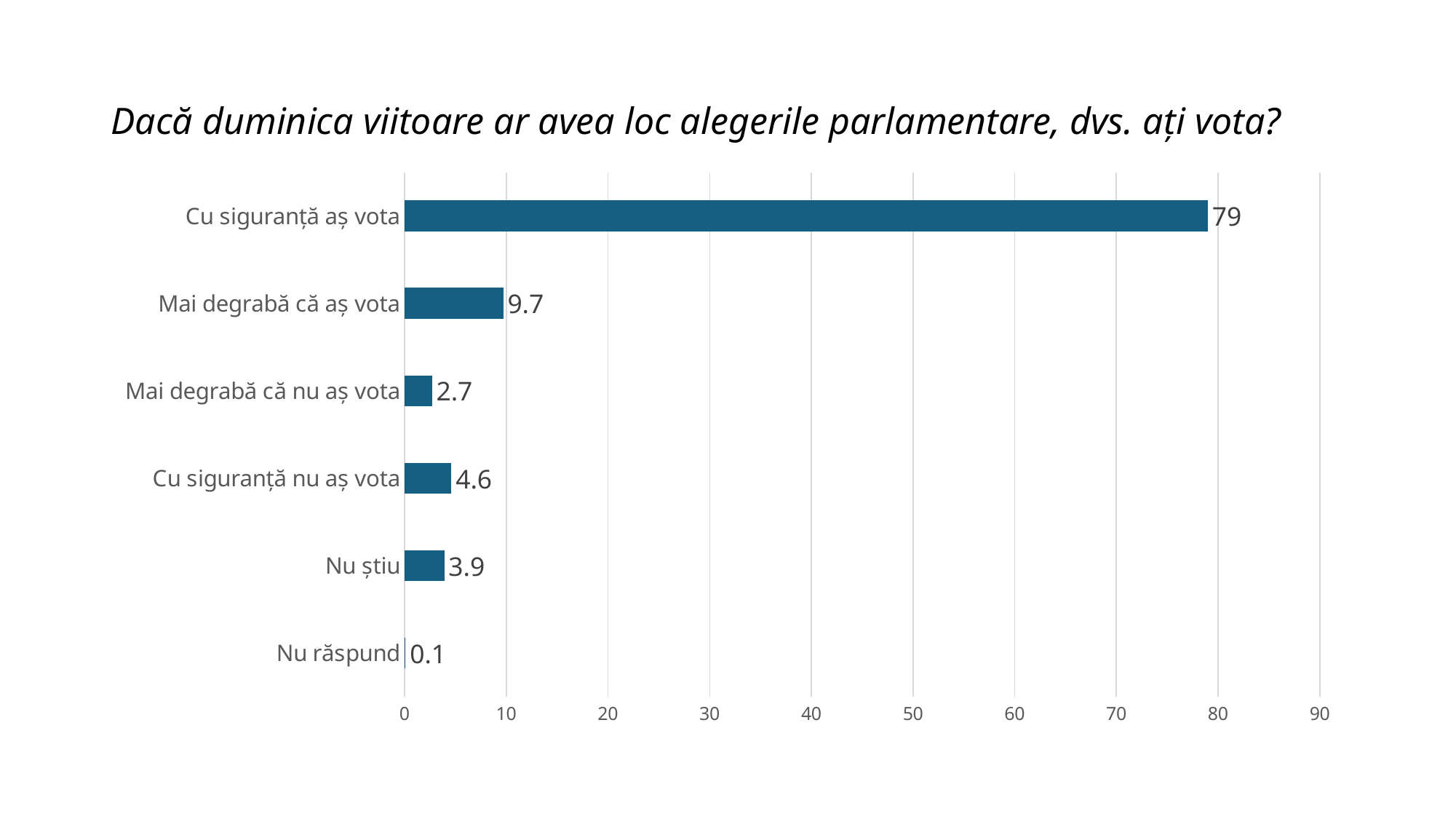
What is the value for "Mai degrabă că aș vota"? 9.7 What is the difference between the values for "Cu siguranță aș vota" and "Mai degrabă că aș vota"? 69.3 What is the value for "Nu știu"? 3.9 What kind of chart is shown on the slide? bar chart What is the value for "Cu siguranță aș vota"? 79 Which category has the highest value? Cu siguranță aș vota Which is larger, the value for "Cu siguranță nu aș vota" or the value for "Mai degrabă că nu aș vota"? Cu siguranță nu aș vota Is the value for "Cu siguranță aș vota" greater or less than 70? greater What is the value for "Nu răspund"? 0.1 What is the title of the chart? Dacă duminica viitoare ar avea loc alegerile parlamentare, dvs. ați vota? Which category has the lowest value? Nu răspund How many categories are shown in the chart? 6